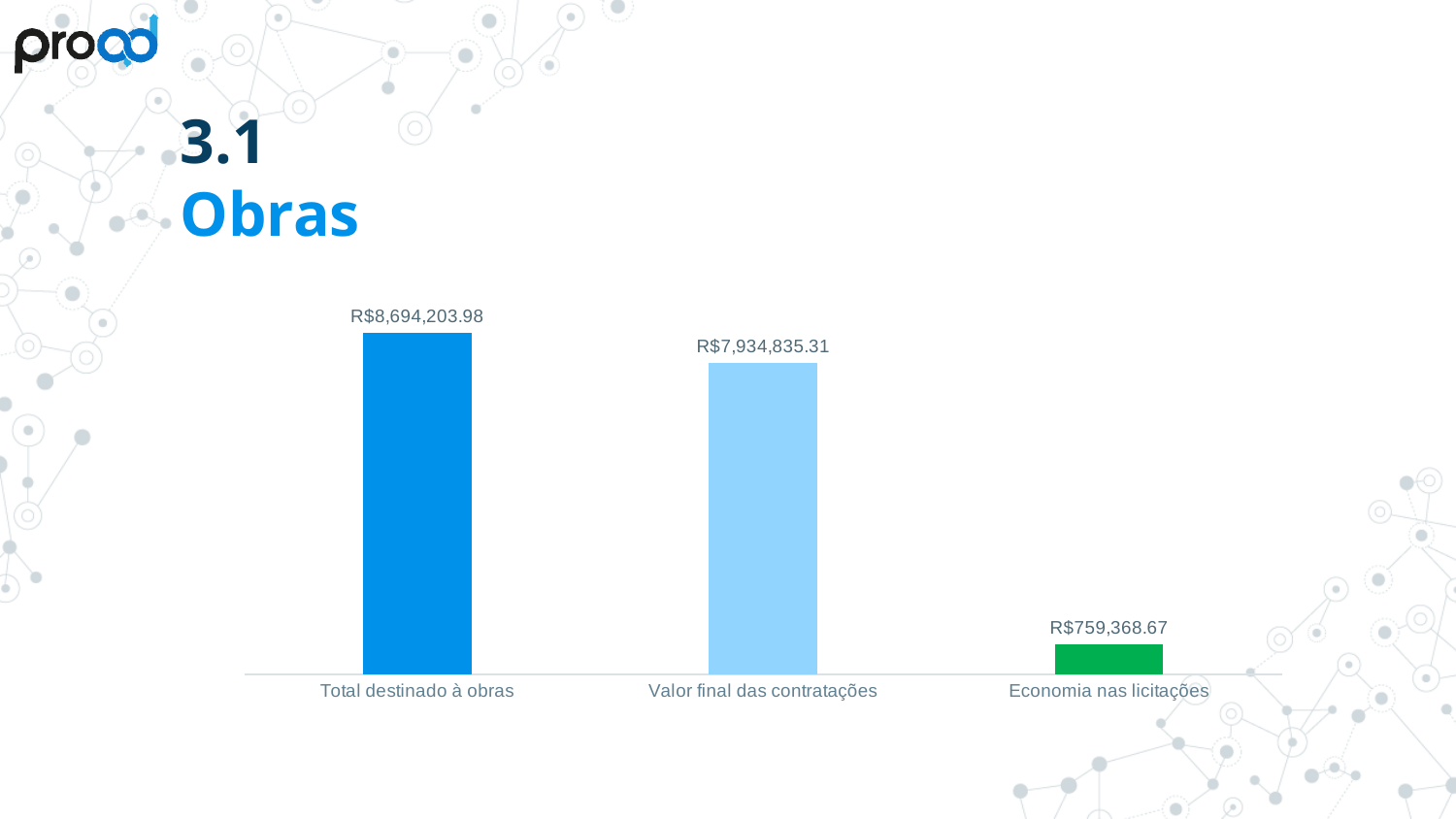
What is the difference between Total destinado à obras and Valor final das contratações? R$759,368.67 What kind of chart is shown on the slide? Bar chart What colour is the bar for Economia nas licitações? Green What is the value for Economia nas licitações? R$759,368.67 How many categories are shown in the chart? 3 Which category has the lowest value? Economia nas licitações Do the values rise or fall from left to right across the categories? Fall What is the value for Total destinado à obras? R$8,694,203.98 What is the difference between Valor final das contratações and Economia nas licitações? R$7,175,466.64 Which category has the highest value? Total destinado à obras What is the value for Valor final das contratações? R$7,934,835.31 Which is larger, Valor final das contratações or Economia nas licitações? Valor final das contratações